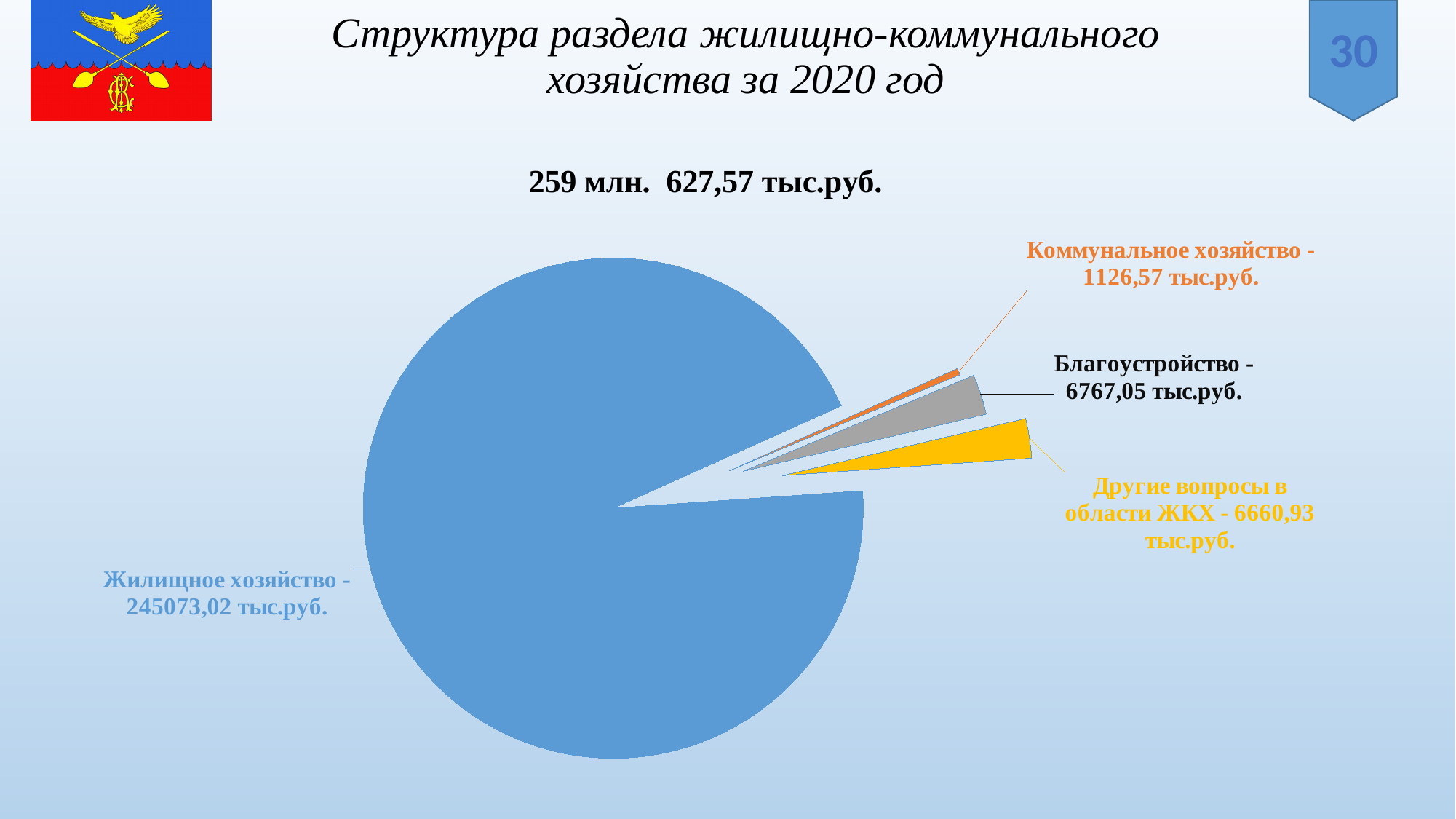
What is the value for Жилищное хозяйство? 245073,02 тыс.руб. What total amount is shown above the pie chart? 259 млн. 627,57 тыс.руб. What is the value for Коммунальное хозяйство? 1126,57 тыс.руб. What is the difference between the values for Благоустройство and Другие вопросы в области ЖКХ? 106,12 тыс.руб. Which category has the smallest slice of the pie? Коммунальное хозяйство What is the difference between the values for Благоустройство and Коммунальное хозяйство? 5640,48 тыс.руб. How many categories are shown in the pie chart? 4 What kind of chart is shown on the slide? Pie chart Which category has the largest slice of the pie? Жилищное хозяйство What is the value for Другие вопросы в области ЖКХ? 6660,93 тыс.руб. What is the value for Благоустройство? 6767,05 тыс.руб. Which is larger, the value for Благоустройство or the value for Другие вопросы в области ЖКХ? Благоустройство